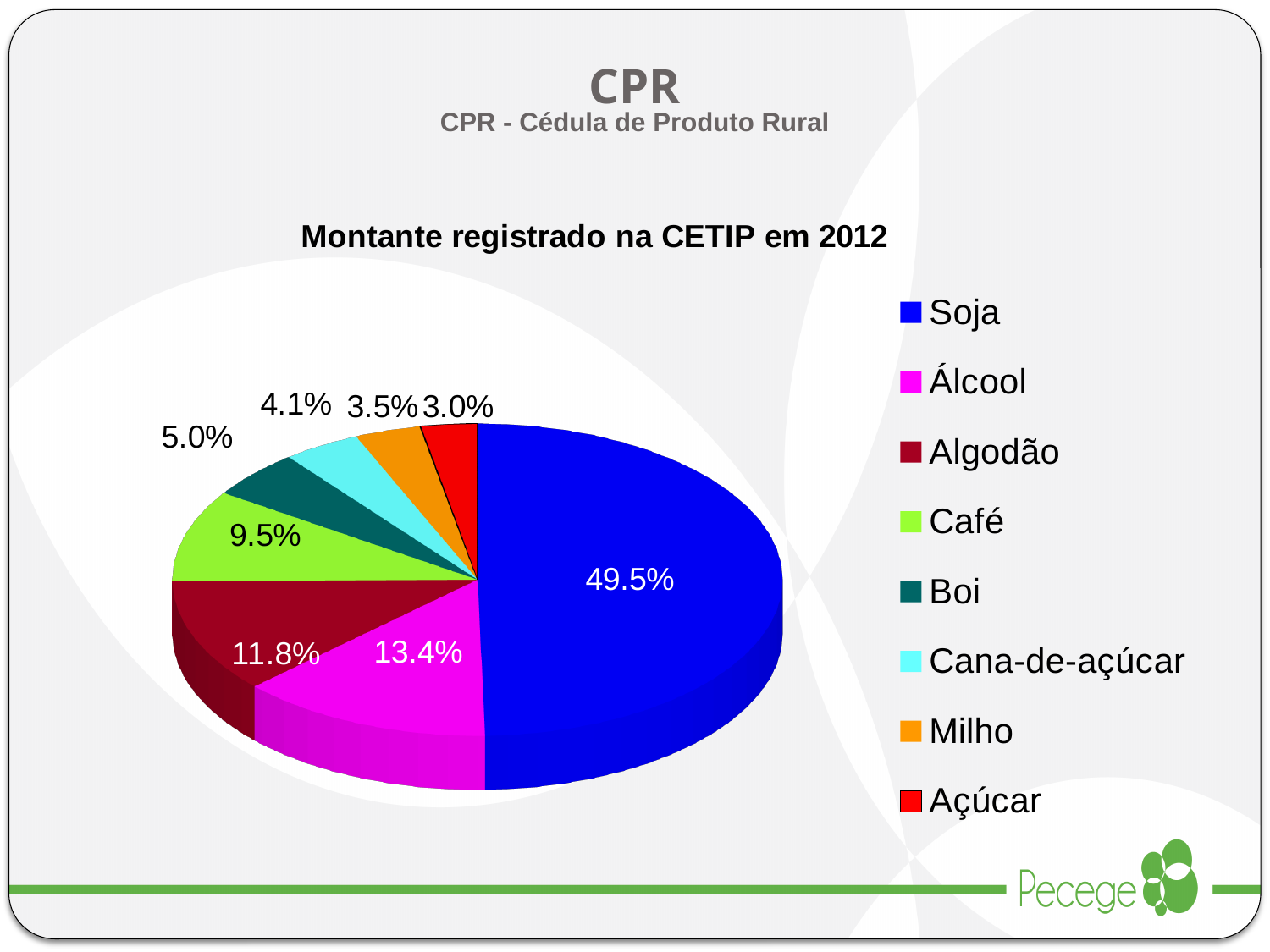
What share of the pie does Café have? 9.5% Which category has the largest slice of the pie? Soja What is the difference between the shares of Álcool and Algodão? 1.6% What share of the pie does Algodão have? 11.8% What share of the pie does Soja have? 49.5% Which category has the smallest slice of the pie? Açúcar What kind of chart is shown on the slide? pie chart What is the title of the chart? Montante registrado na CETIP em 2012 Which has a larger share, Boi or Milho? Boi How many categories does the pie chart show? 8